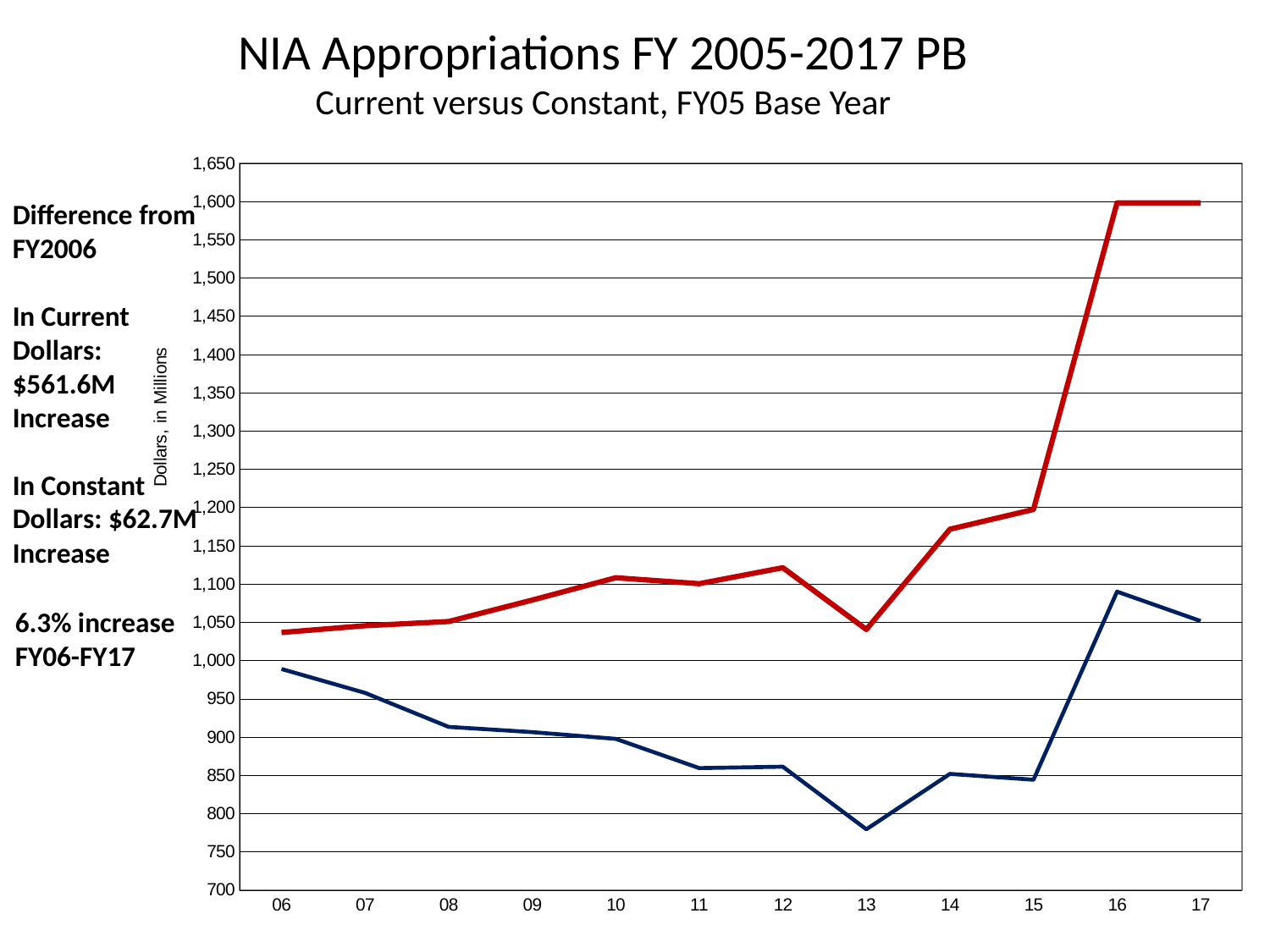
Is the value of the red line at 13 greater or less than 1,100? less Is the value of the blue line at 13 greater or less than 800? less What kind of chart is shown on the slide? line chart How many fiscal years are plotted along the x axis? 12 What is the subtitle of the chart? Current versus Constant, FY05 Base Year In which year does the blue line reach its highest value? 16 In which year does the blue line reach its lowest value? 13 Is the value of the red line at 14 greater or less than 1,200? less Does the blue line rise or fall from 06 to 13? fall What is the label on the vertical axis? Dollars, in Millions